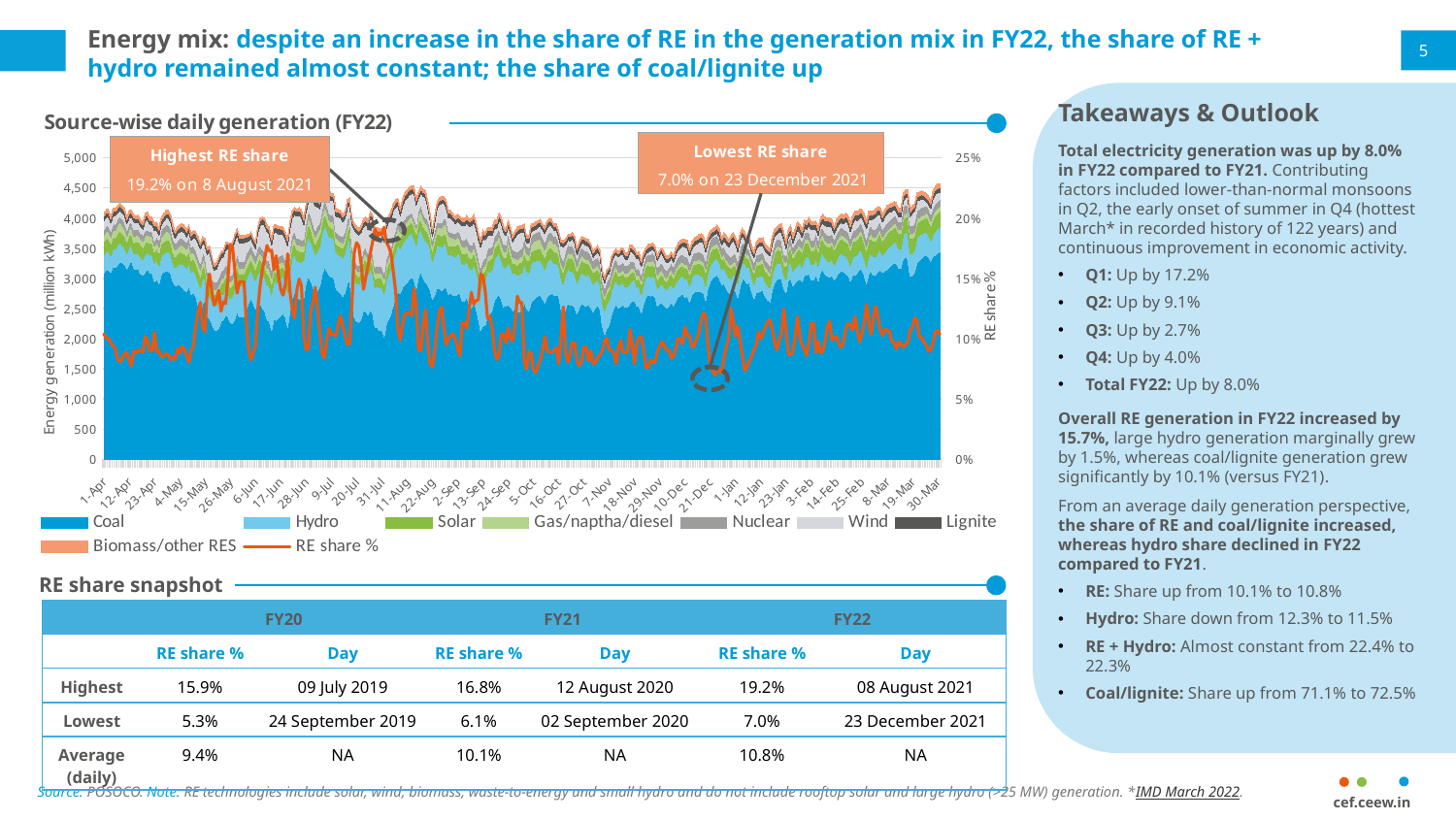
On which date did the lowest RE share occur according to the chart annotation? 23 December 2021 What is the label of the left vertical axis of the chart? Energy generation (million kWh) What kind of chart is used to show source-wise daily generation? Stacked area chart with a line for RE share % What was the lowest RE share shown on the chart? 7.0% Is the RE share on 8 August 2021 greater or less than 15%? greater What is the title of the chart on the slide? Source-wise daily generation (FY22) What was the highest RE share shown on the chart? 19.2% On which date did the highest RE share occur according to the chart annotation? 8 August 2021 Which generation source occupies the largest area in the stacked chart? Coal How many series does the chart legend list? 9 Is the RE share on 23 December 2021 greater or less than 10%? less What is the difference between the highest and lowest RE share annotated on the chart? 12.2 percentage points